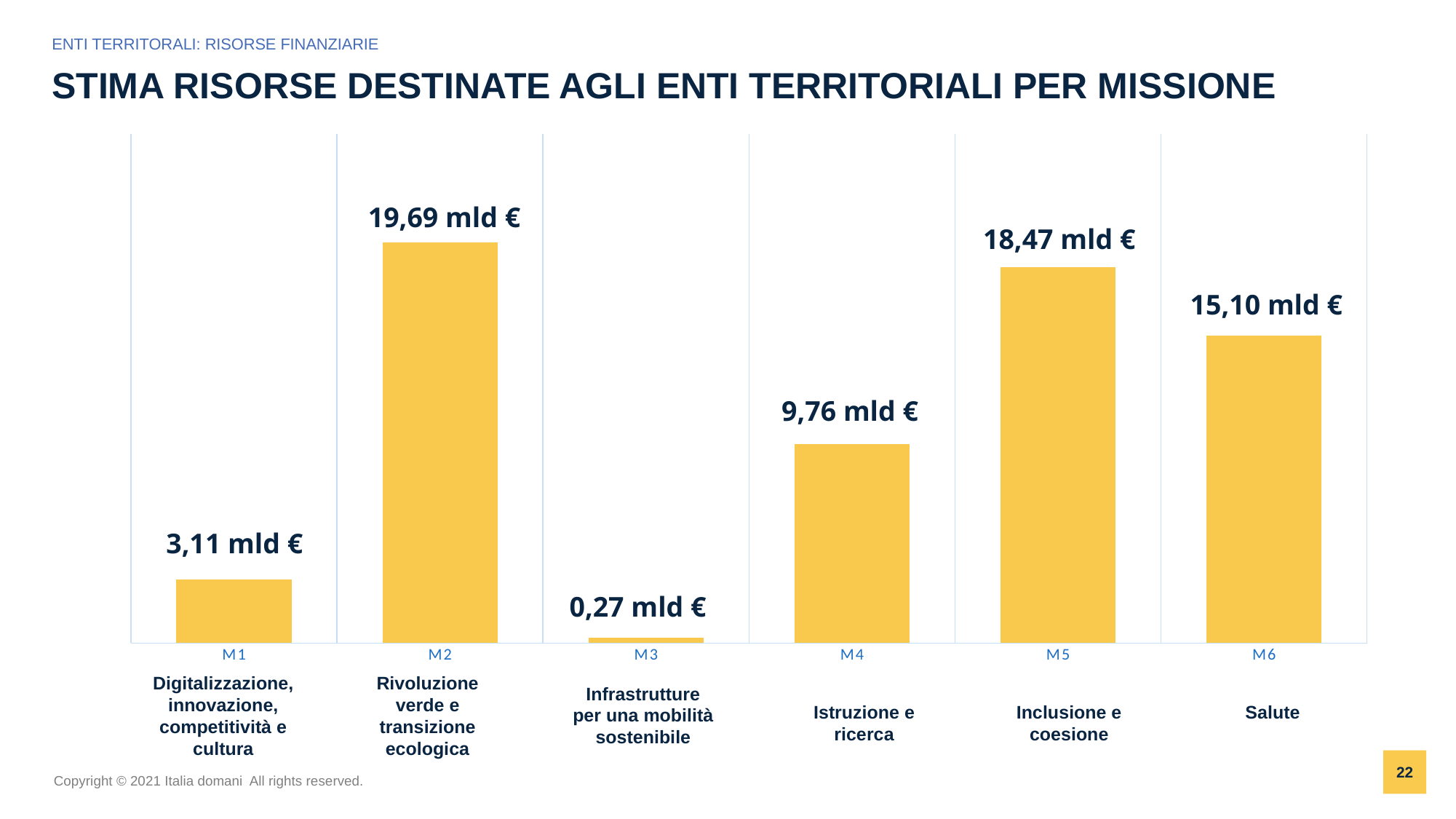
What is the title of the chart? STIMA RISORSE DESTINATE AGLI ENTI TERRITORIALI PER MISSIONE What is the value for M2 (Rivoluzione verde e transizione ecologica)? 19,69 mld € Which is larger, the value for M4 or the value for M1? M4 Which mission has the lowest value? M3 (Infrastrutture per una mobilità sostenibile) What is the value for M3 (Infrastrutture per una mobilità sostenibile)? 0,27 mld € What kind of chart is shown on the slide? Bar chart Which mission has the highest value? M2 (Rivoluzione verde e transizione ecologica) What is the value for M4 (Istruzione e ricerca)? 9,76 mld € What is the difference between the values for M5 and M6? 3,37 mld € What is the value for M6 (Salute)? 15,10 mld € What is the difference between the values for M2 and M5? 1,22 mld € How many missions are shown in the chart? 6